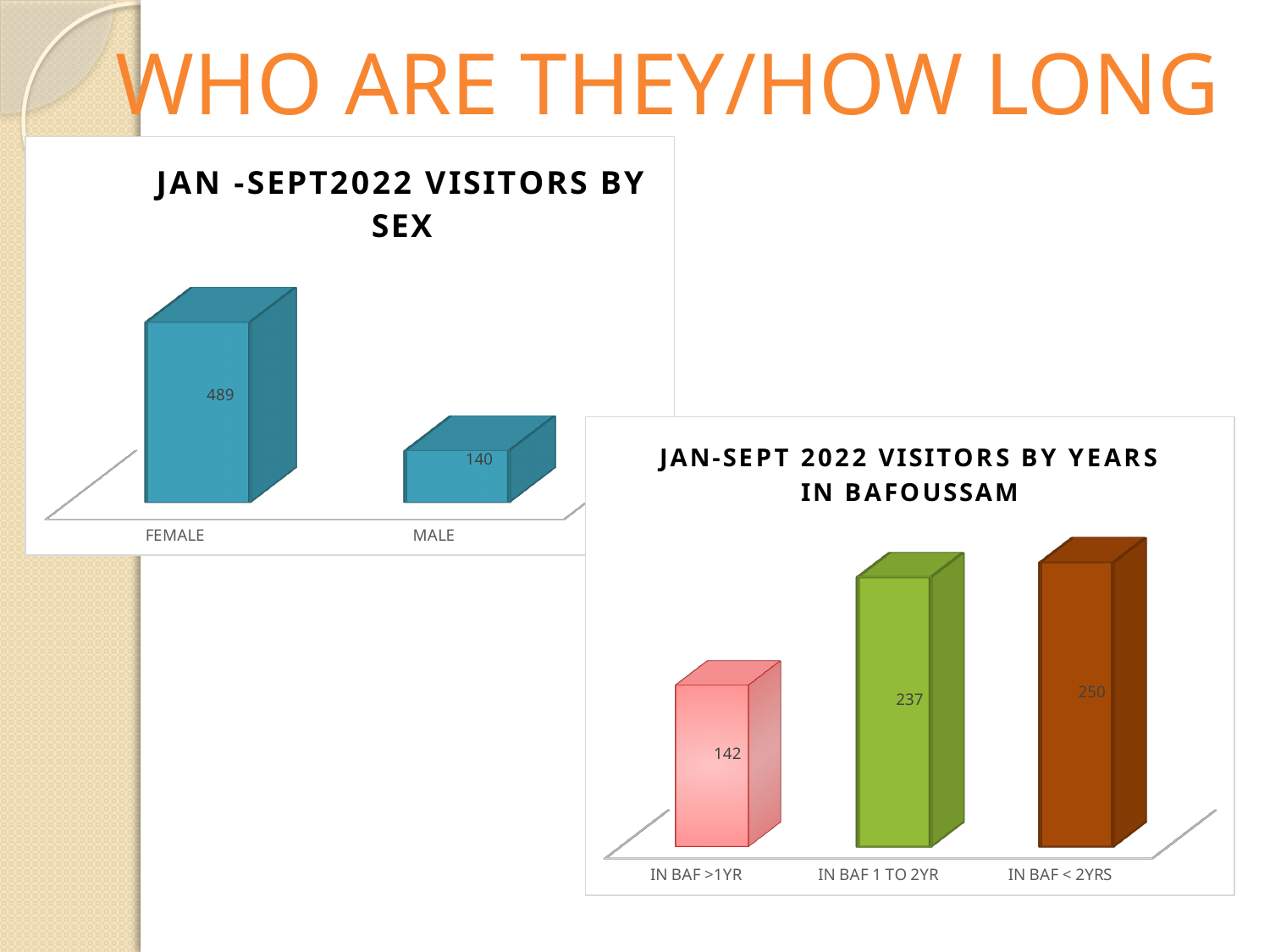
In the 'JAN-SEPT 2022 VISITORS BY YEARS IN BAFOUSSAM' chart, what is the difference between the IN BAF < 2YRS and IN BAF >1YR values? 108 In the 'JAN-SEPT 2022 VISITORS BY YEARS IN BAFOUSSAM' chart, what is the value for IN BAF 1 TO 2YR? 237 In the 'JAN-SEPT 2022 VISITORS BY YEARS IN BAFOUSSAM' chart, how many categories are shown? 3 What kind of chart is the 'JAN -SEPT2022 VISITORS BY SEX' chart? Bar chart In the 'JAN-SEPT 2022 VISITORS BY YEARS IN BAFOUSSAM' chart, which category has the lowest value? IN BAF >1YR In the 'JAN-SEPT 2022 VISITORS BY YEARS IN BAFOUSSAM' chart, do the values rise or fall from left to right? Rise In the 'JAN-SEPT 2022 VISITORS BY YEARS IN BAFOUSSAM' chart, what is the value for IN BAF >1YR? 142 In the 'JAN -SEPT2022 VISITORS BY SEX' chart, what is the value for MALE? 140 In the 'JAN -SEPT2022 VISITORS BY SEX' chart, what is the difference between the FEMALE and MALE values? 349 In the 'JAN -SEPT2022 VISITORS BY SEX' chart, which category has the highest value? FEMALE In the 'JAN -SEPT2022 VISITORS BY SEX' chart, what is the value for FEMALE? 489 In the 'JAN -SEPT2022 VISITORS BY SEX' chart, how many categories are shown? 2